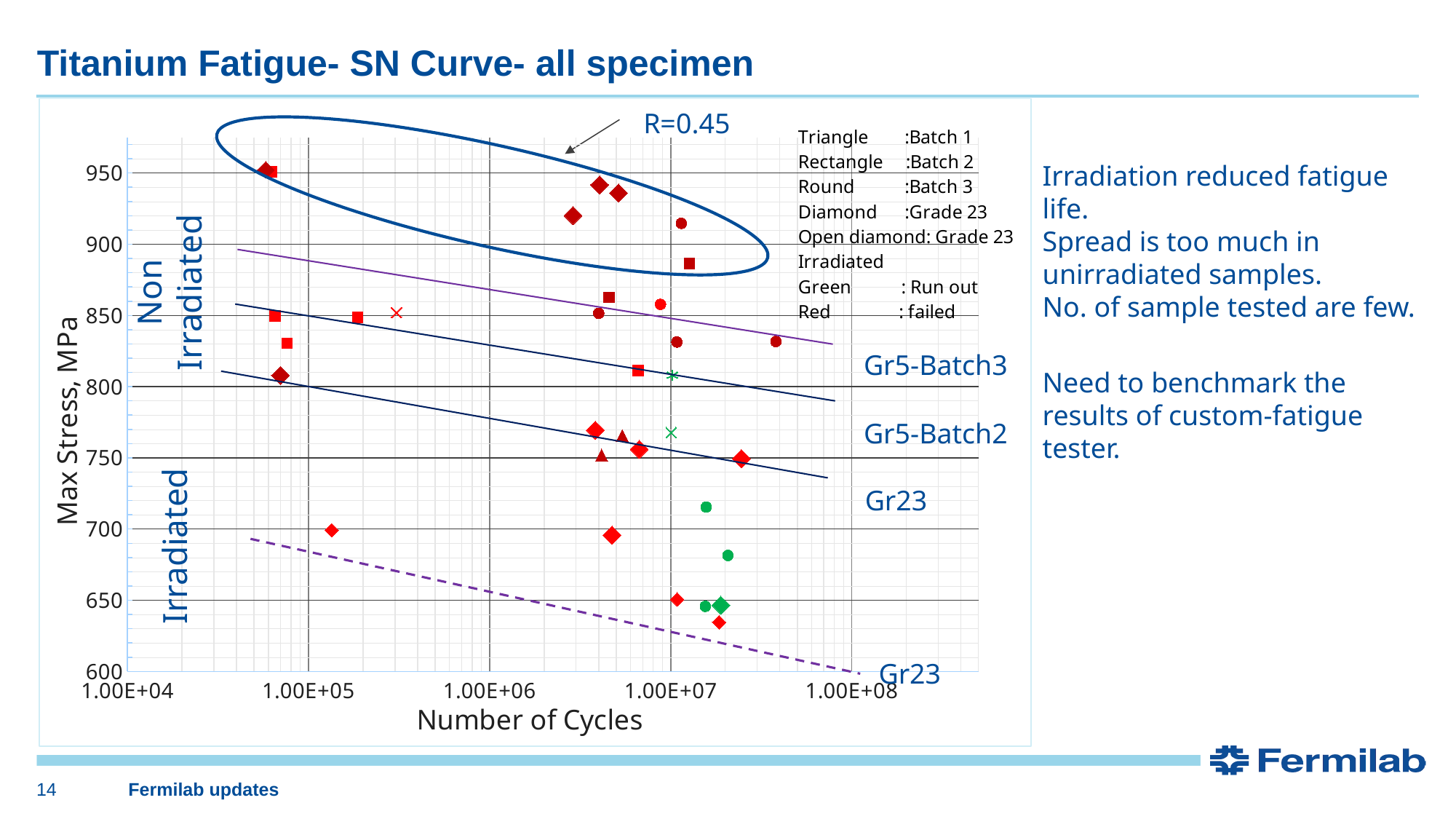
What is the title of the chart on the slide? Titanium Fatigue- SN Curve- all specimen Is the max stress of the lowest red diamond point (near 2.00E+07 cycles) greater or less than 650 MPa? less What is the label of the horizontal axis? Number of Cycles What is the R value annotated on the chart? R=0.45 Is the max stress of the green round points (run-outs) greater or less than 750 MPa? less Is the max stress of the highest red data points (near 1.00E+05 cycles) greater or less than 900 MPa? greater As the number of cycles increases, do the fitted trend lines for max stress rise or fall? Fall What is the label of the vertical axis? Max Stress, MPa What kind of chart is shown on the slide? Scatter chart What is the lowest value shown on the horizontal (Number of Cycles) axis? 1.00E+04 According to the chart's legend text, which marker shape represents Batch 2? Rectangle How many labelled tick values are shown on the vertical (Max Stress) axis? 8